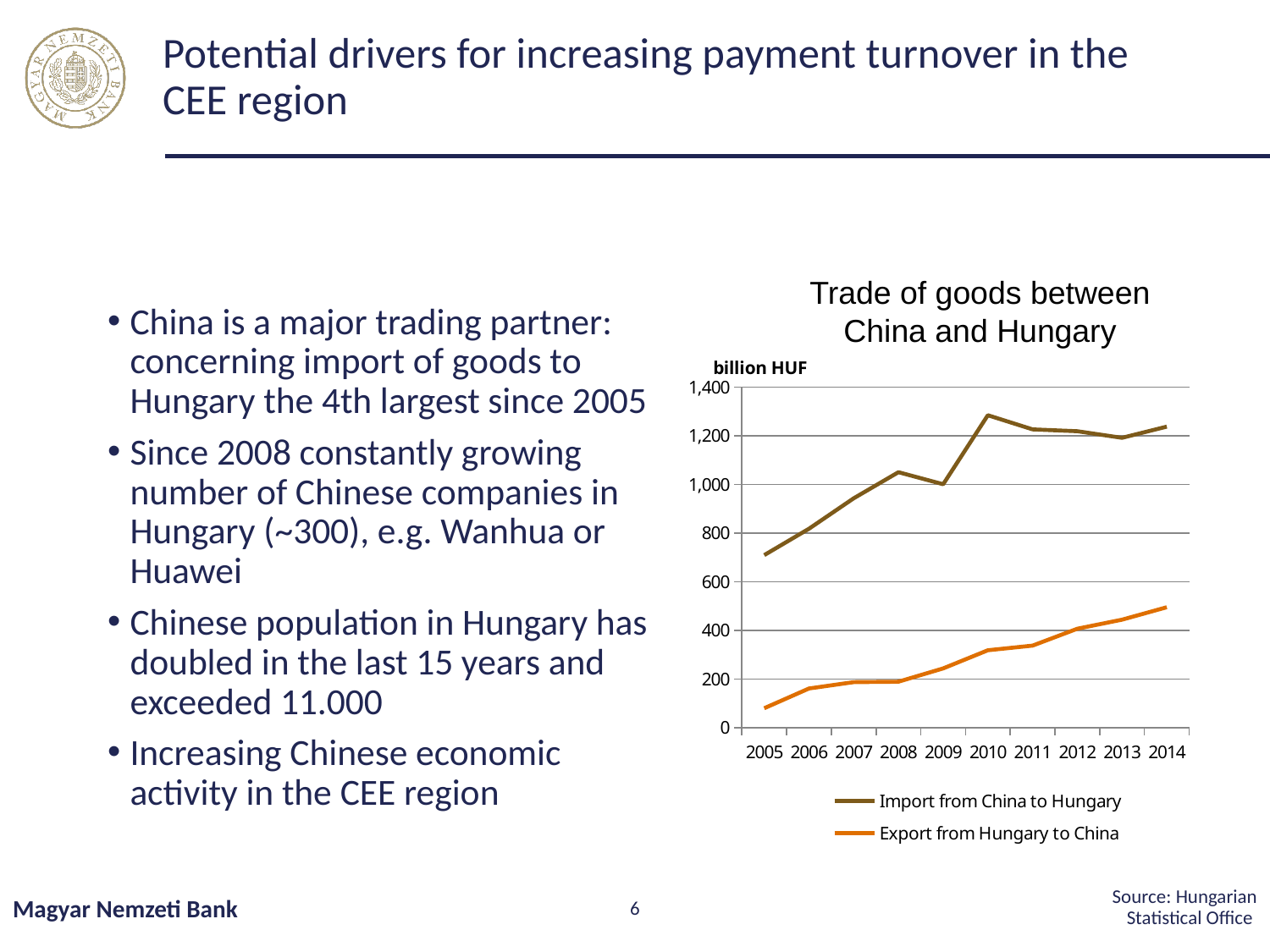
What unit is shown on the chart's vertical axis? billion HUF In which year is the Import from China to Hungary highest? 2010 Is the value for Export from Hungary to China in 2014 greater or less than 600? less What kind of chart is shown on the slide? line chart Which is larger in 2014, Import from China to Hungary or Export from Hungary to China? Import from China to Hungary In which year is the Export from Hungary to China highest? 2014 How many series does the chart legend list? 2 Does the Export from Hungary to China generally rise or fall from 2005 to 2014? rise Is the value for Import from China to Hungary in 2010 greater or less than 1,200? greater How many years are plotted along the x axis of the chart? 10 In which year is the Import from China to Hungary lowest? 2005 Is the value for Import from China to Hungary in 2005 greater or less than 800? less